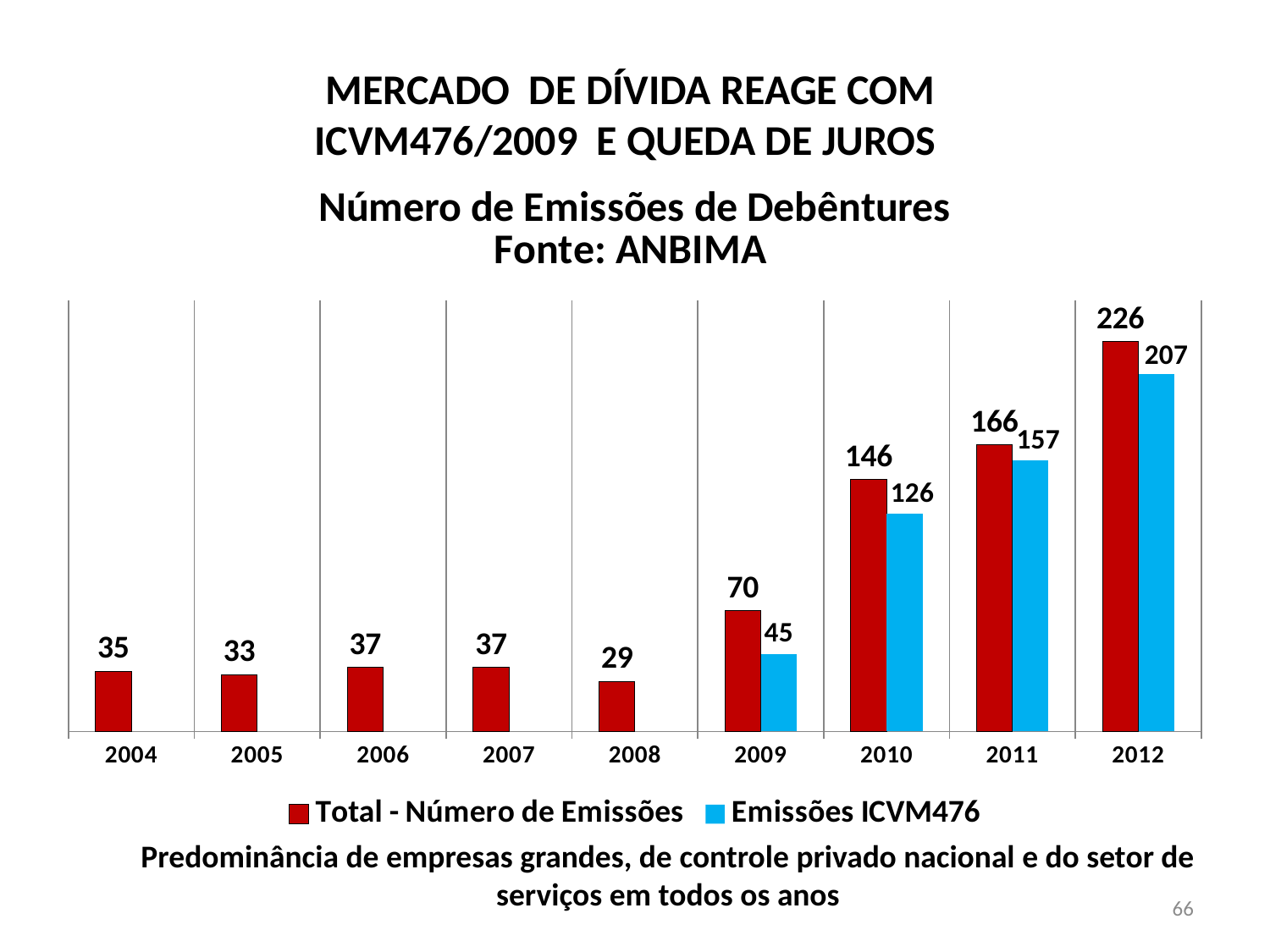
Which year has the highest value for Total - Número de Emissões? 2012 From 2009 to 2012, does Emissões ICVM476 rise or fall? Rise What kind of chart is shown on the slide? Bar chart What is the difference between Total - Número de Emissões and Emissões ICVM476 in 2011? 9 Which is larger: Emissões ICVM476 in 2009 or Total - Número de Emissões in 2006? Emissões ICVM476 in 2009 Which year has the lowest value for Total - Número de Emissões? 2008 How many years are shown on the x axis? 9 What is the difference between Total - Número de Emissões in 2012 and in 2009? 156 What is the value of Total - Número de Emissões for 2012? 226 What is the value of Emissões ICVM476 for 2010? 126 How many series does the legend list? 2 What is the value of Total - Número de Emissões for 2008? 29